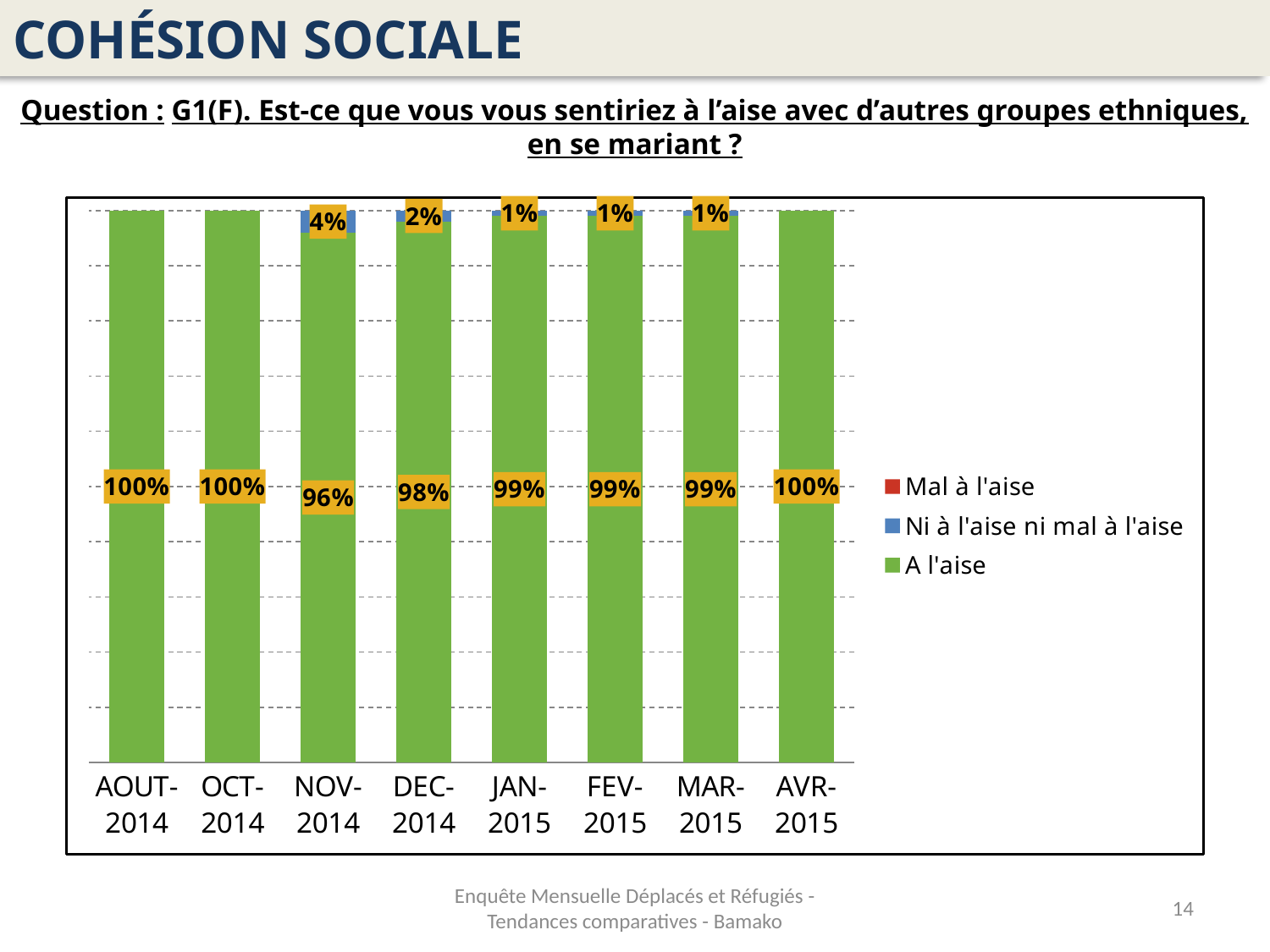
In which month is the value for "A l'aise" lowest? NOV-2014 What kind of chart is shown on the slide? stacked bar chart How many months are shown on the x axis? 8 What is the value for "A l'aise" in NOV-2014? 96% How many series does the legend list? 3 Which legend entry is shown in green? A l'aise What is the difference between the "A l'aise" values for AOUT-2014 and NOV-2014? 4% What is the value for "Ni à l'aise ni mal à l'aise" in NOV-2014? 4% What is the value for "Ni à l'aise ni mal à l'aise" in DEC-2014? 2% Which is larger, the "A l'aise" value for NOV-2014 or for DEC-2014? DEC-2014 What is the value for "A l'aise" in DEC-2014? 98% What is the value for "A l'aise" in JAN-2015? 99%